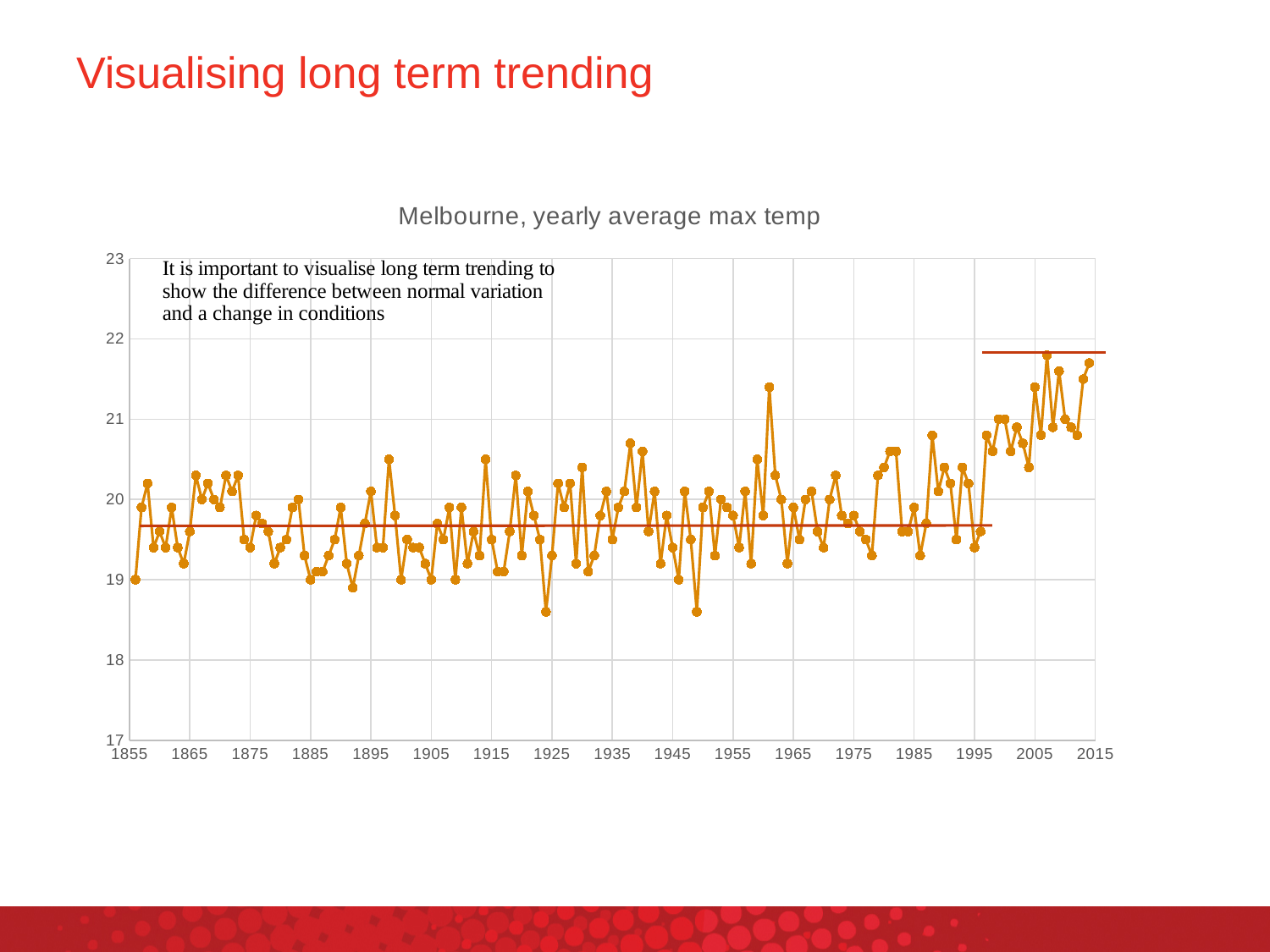
Do the yearly average max temperature values generally rise or fall from 1855 to 2015? rise What is the highest value shown on the y axis of the chart? 23 What kind of chart is shown on the slide? line chart Are the values after 2000 generally higher or lower than the values before 1900? higher What is the title of the chart? Melbourne, yearly average max temp Is the value for the low point around 1924 greater or less than 19? less Is the value for 1875 greater or less than 20? less Which year has the larger value, 1961 or 1924? 1961 Is the value for the peak around 1961 greater or less than 21? greater